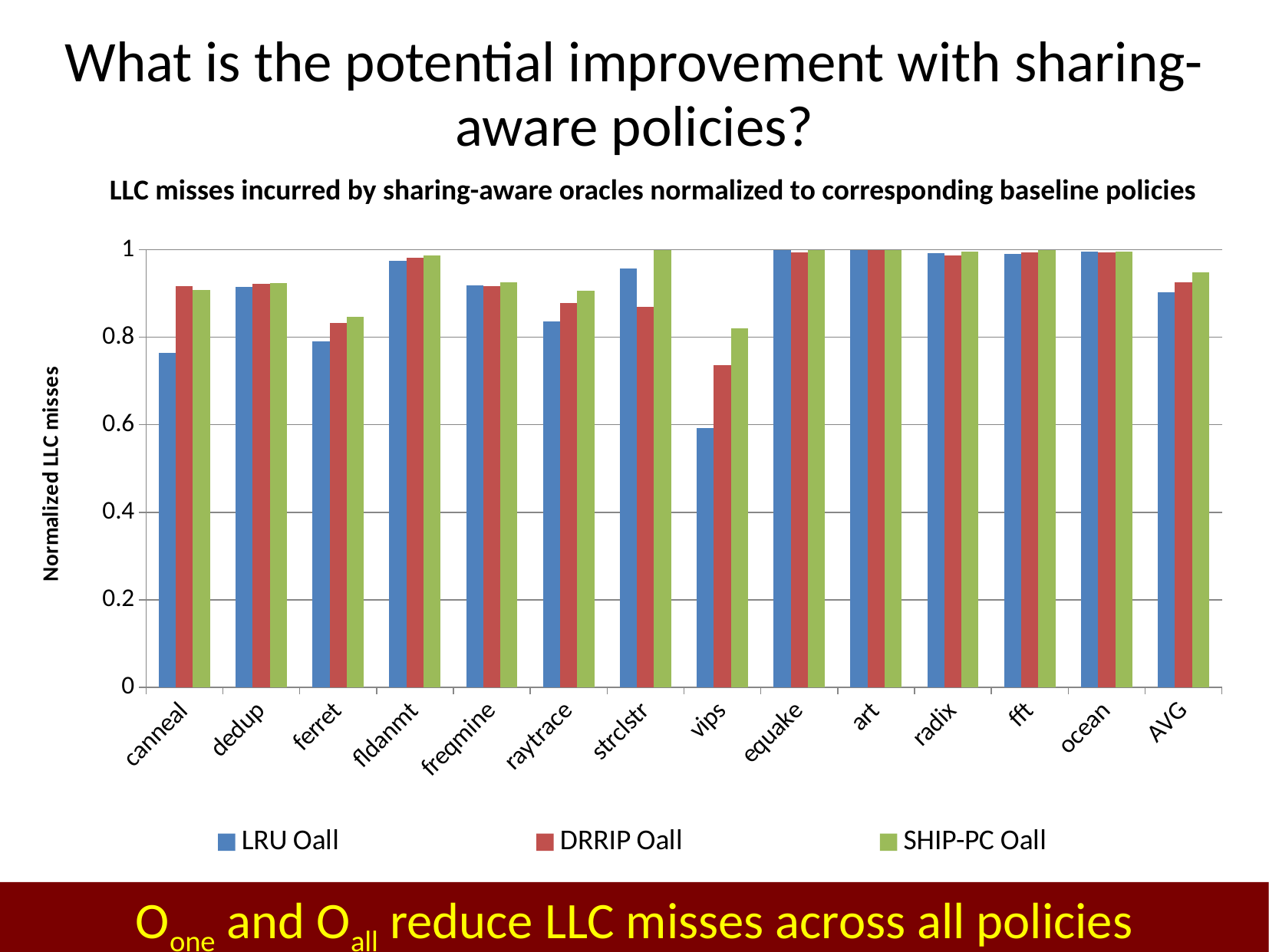
Which category has the lowest value for the DRRIP Oall series? vips What kind of chart is shown on the slide? bar chart Is the LRU Oall value for canneal greater or less than 0.8? less How many categories are shown along the x axis? 14 How many series does the legend list? 3 Which category has the lowest value for the LRU Oall series? vips For vips, which is larger: the LRU Oall value or the SHIP-PC Oall value? SHIP-PC Oall Which category has the lowest value for the SHIP-PC Oall series? vips Is the LRU Oall value for vips greater or less than 0.8? less Is the DRRIP Oall value for vips greater or less than 0.8? less What is the label of the y axis? Normalized LLC misses For strclstr, which is larger: the DRRIP Oall value or the SHIP-PC Oall value? SHIP-PC Oall